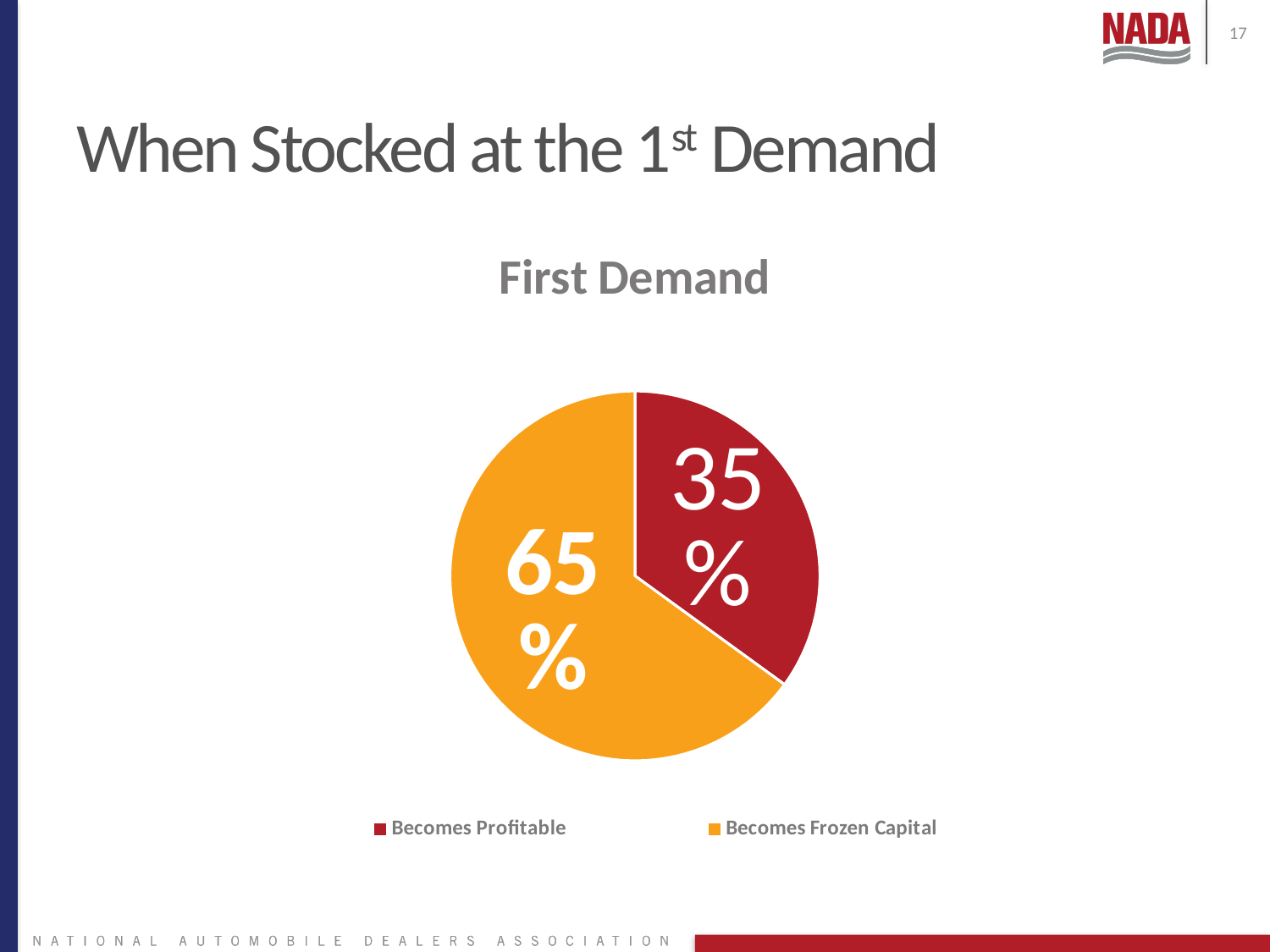
How many entries does the legend list? 2 What is the difference in percentage points between 'Becomes Frozen Capital' and 'Becomes Profitable'? 30 What percentage of the pie is labelled 'Becomes Profitable'? 35% What percentage of the pie is labelled 'Becomes Frozen Capital'? 65% What colour is the 'Becomes Profitable' slice? red What share of the pie does 'Becomes Frozen Capital' represent? 65% Which slice is the smallest in the pie chart? Becomes Profitable Which is larger, 'Becomes Profitable' or 'Becomes Frozen Capital'? Becomes Frozen Capital What type of chart is shown on the slide? pie chart How many slices does the pie chart have? 2 Which slice is the largest in the pie chart? Becomes Frozen Capital What is the title of the chart? First Demand